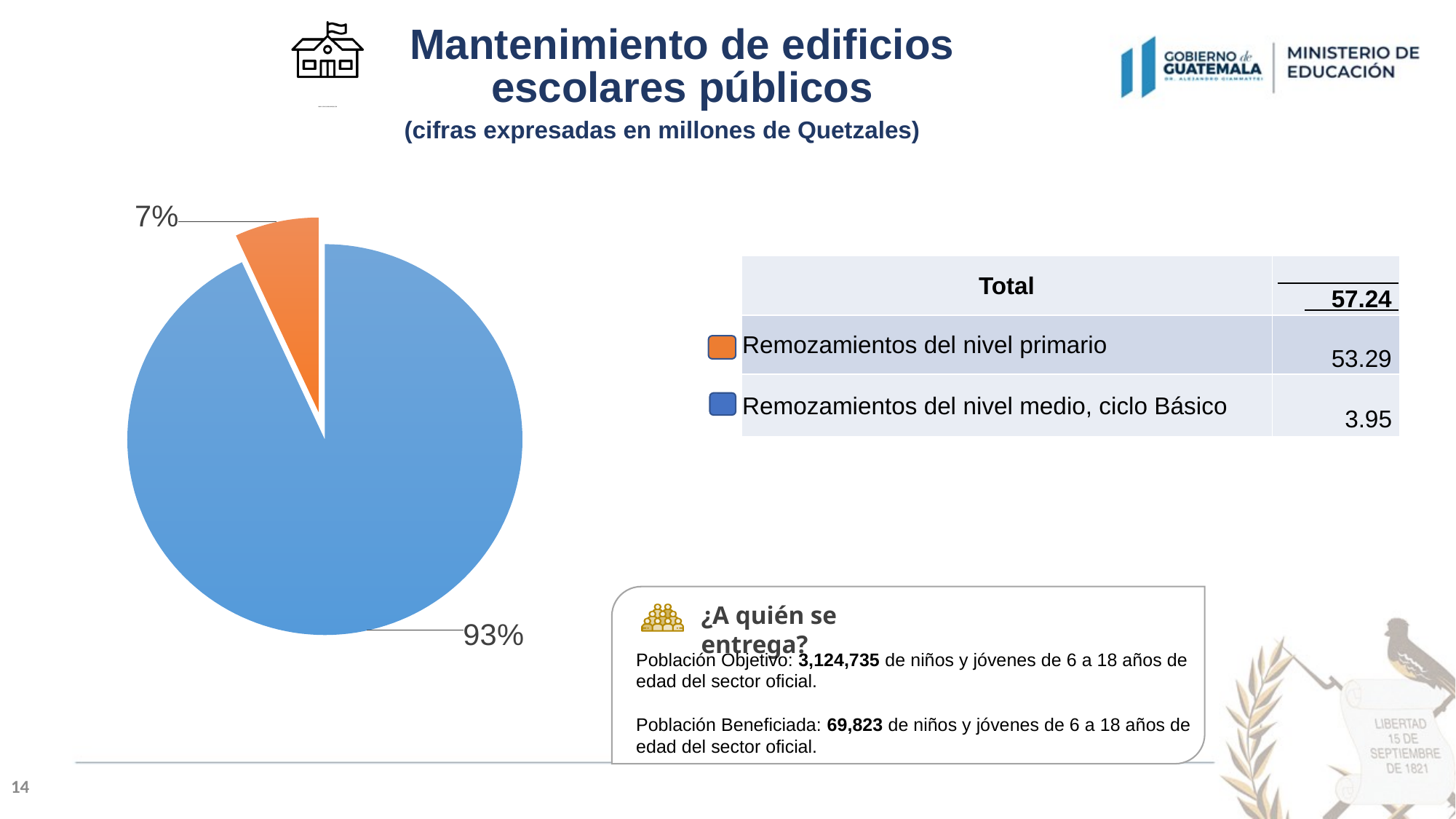
Which category has the smallest value in the table? Remozamientos del nivel medio, ciclo Básico Is the share of the blue slice greater or less than 50%? greater What value is shown for Remozamientos del nivel medio, ciclo Básico? 3.95 What percentage is shown for the orange slice of the pie chart? 7% What value is shown for Remozamientos del nivel primario? 53.29 What kind of chart is shown on the slide? pie chart What percentage is shown for the blue slice of the pie chart? 93% Which category has the larger value, Remozamientos del nivel primario or Remozamientos del nivel medio, ciclo Básico? Remozamientos del nivel primario In what unit are the figures on the slide expressed, according to the subtitle? millones de Quetzales What is the difference between the values for Remozamientos del nivel primario and Remozamientos del nivel medio, ciclo Básico? 49.34 What is the total value shown in the table next to the pie chart? 57.24 How many slices does the pie chart have? 2